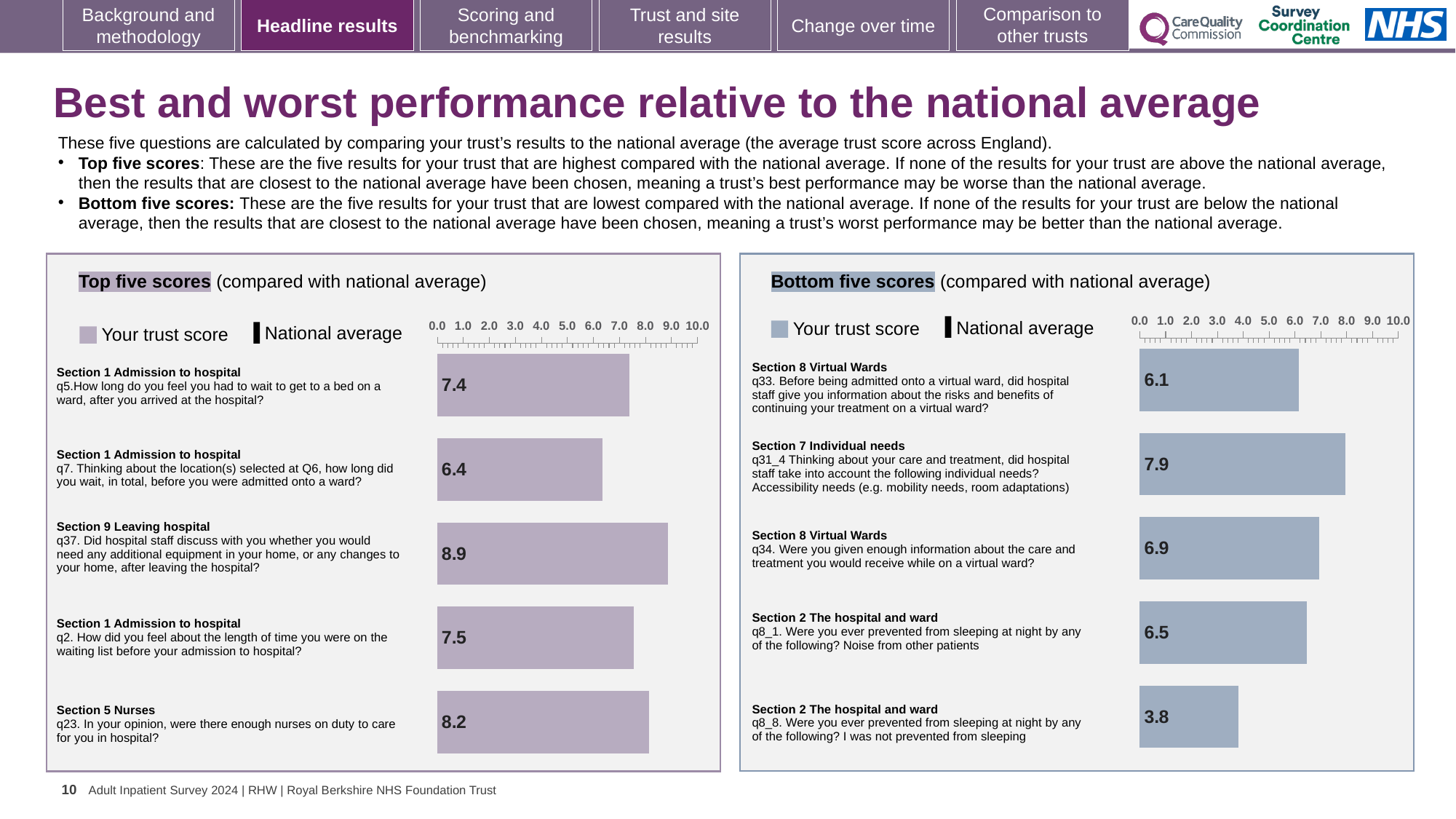
How many bars are shown in the Bottom five scores chart? 5 In the Top five scores chart, what is the trust score for q23 (were there enough nurses on duty)? 8.2 In the Bottom five scores chart, which question has the highest trust score? q31_4 In the Bottom five scores chart, which has the larger trust score, q34 or q8_1? q34 In the Bottom five scores chart, what is the trust score for q33 (information about risks and benefits of a virtual ward)? 6.1 In the Bottom five scores chart, which question has the lowest trust score? q8_8 What type of chart is used in the Top five scores panel? Bar chart In the Top five scores chart, which question has the highest trust score? q37 In the Top five scores chart, what is the trust score for q5 (how long you had to wait to get to a bed on a ward)? 7.4 In the Top five scores chart, what is the difference between the trust scores for q37 and q7? 2.5 In the Top five scores chart, which question has the lowest trust score? q7 In the Bottom five scores chart, what is the trust score for q8_8 (I was not prevented from sleeping)? 3.8